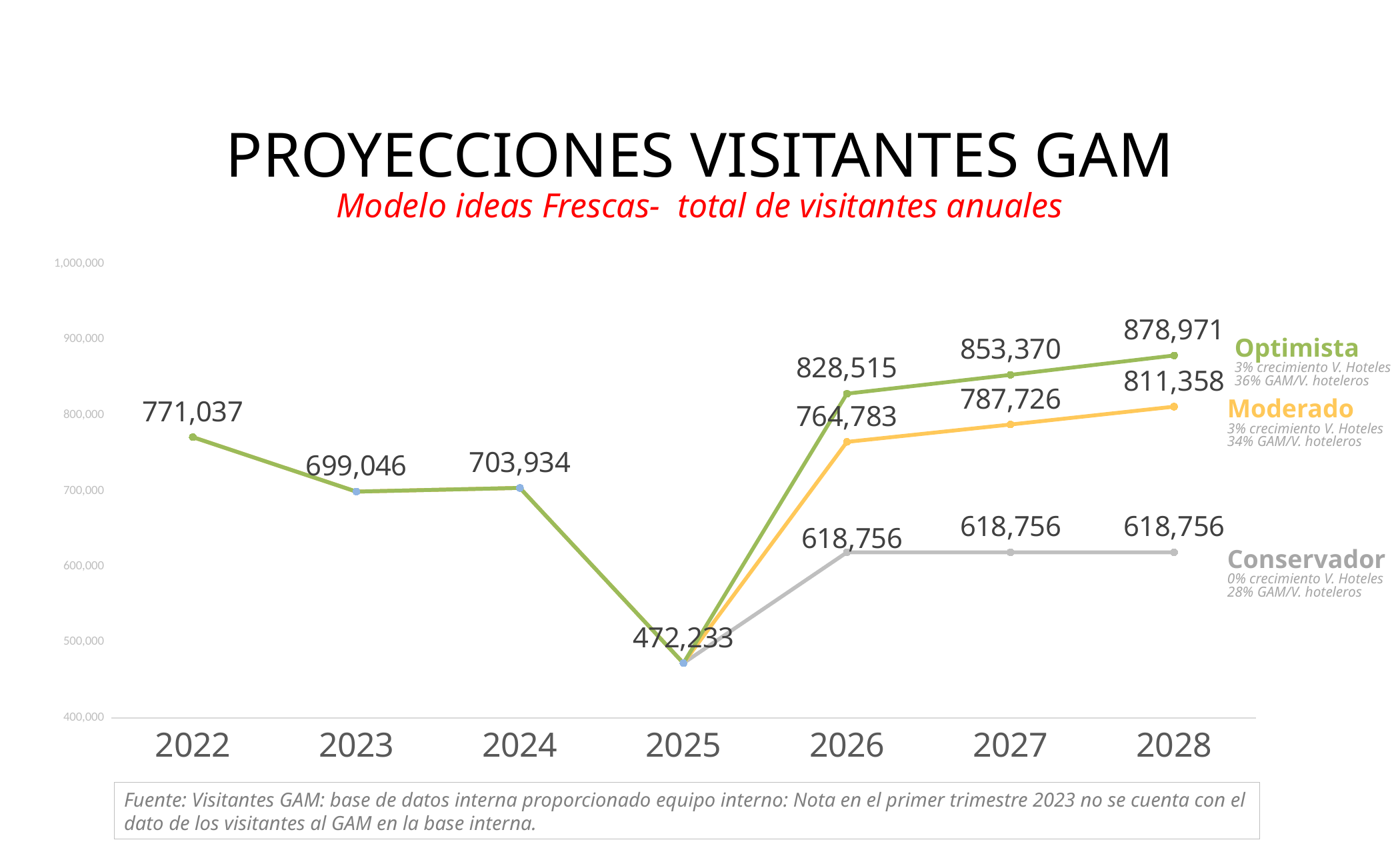
How many years are shown on the x axis? 7 Does the Conservador scenario rise, fall or stay flat from 2026 to 2028? Stays flat What is the difference between the Optimista and Moderado projections for 2028? 67,613 What is the projected value for the Moderado scenario in 2027? 787,726 Which year has the larger value, 2023 or 2024? 2024 How many projection scenarios are labelled on the chart? 3 What is the projected value for the Optimista scenario in 2028? 878,971 What is the total number of visitors shown for 2022? 771,037 What is the difference between the 2022 value and the 2025 value? 298,804 What is the projected value for the Conservador scenario in 2026? 618,756 What kind of chart is shown on the slide? Line chart Which year has the lowest number of visitors on the chart? 2025